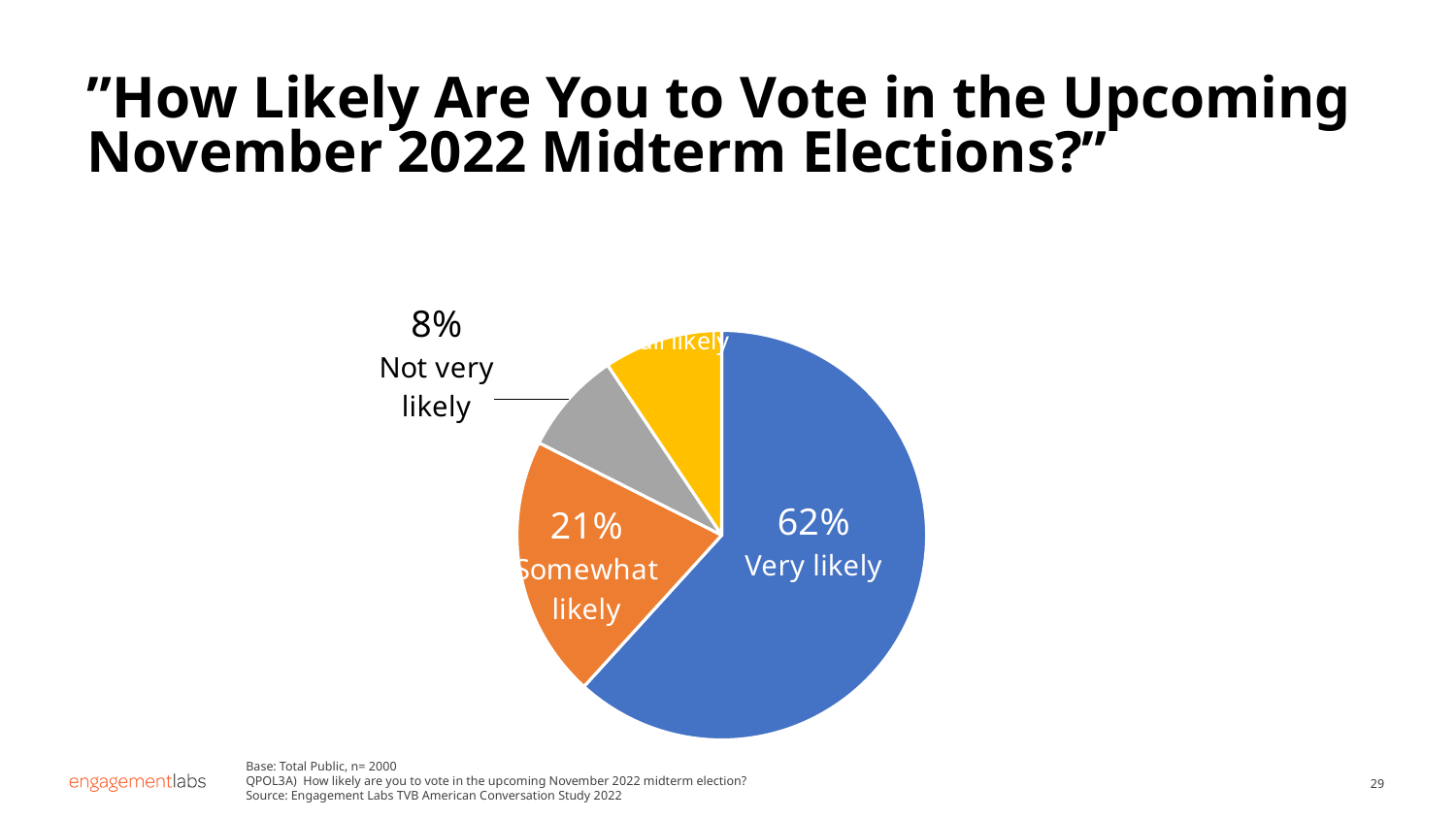
What colour is the "Very likely" slice? Blue How many slices does the pie chart have? 4 Which is larger, the "Somewhat likely" slice or the "Not very likely" slice? Somewhat likely What percentage of respondents said they are "Not very likely" to vote? 8% What kind of chart is shown on the slide? Pie chart What percentage of respondents said they are "Somewhat likely" to vote? 21% What share of the pie does the "Very likely" slice represent? 62% What is the title of the slide? "How Likely Are You to Vote in the Upcoming November 2022 Midterm Elections?" What is the difference between the "Very likely" and "Somewhat likely" percentages? 41% What percentage of respondents said they are "Very likely" to vote? 62% Which response has the largest slice of the pie? Very likely What is the difference between the "Somewhat likely" and "Not very likely" percentages? 13%